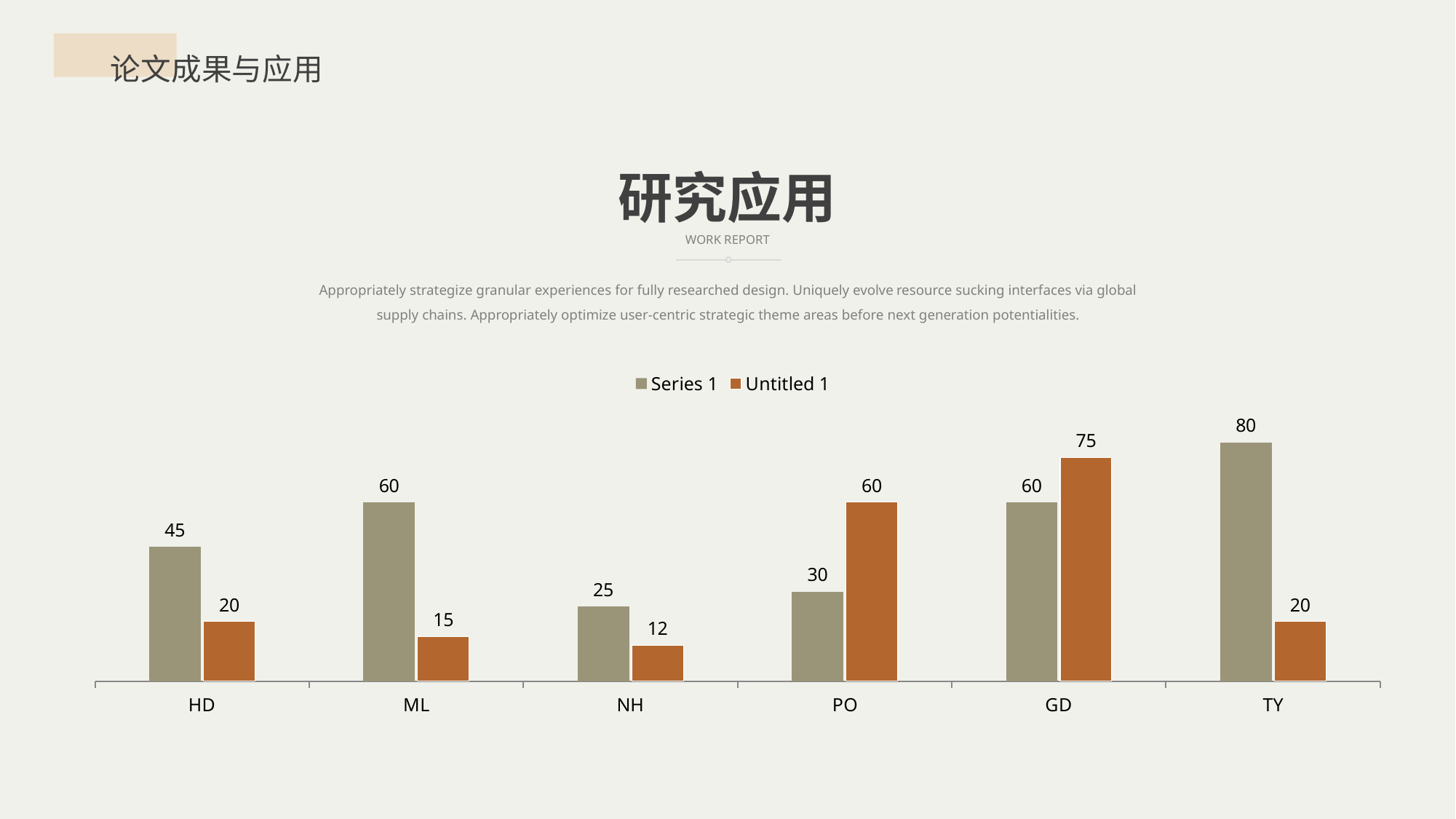
What is the value of Untitled 1 for GD? 75 Which category has the lowest Untitled 1 value? NH What is the value of Series 1 for HD? 45 Which category has the highest Series 1 value? TY What are the two series names listed in the legend? Series 1 and Untitled 1 How many series does the legend list? 2 What is the difference between the Series 1 and Untitled 1 values for ML? 45 What is the difference between the Series 1 values for TY and HD? 35 How many categories are shown on the x axis? 6 What is the value of Untitled 1 for NH? 12 For PO, which series has the larger value, Series 1 or Untitled 1? Untitled 1 What kind of chart is shown on the slide? Bar chart